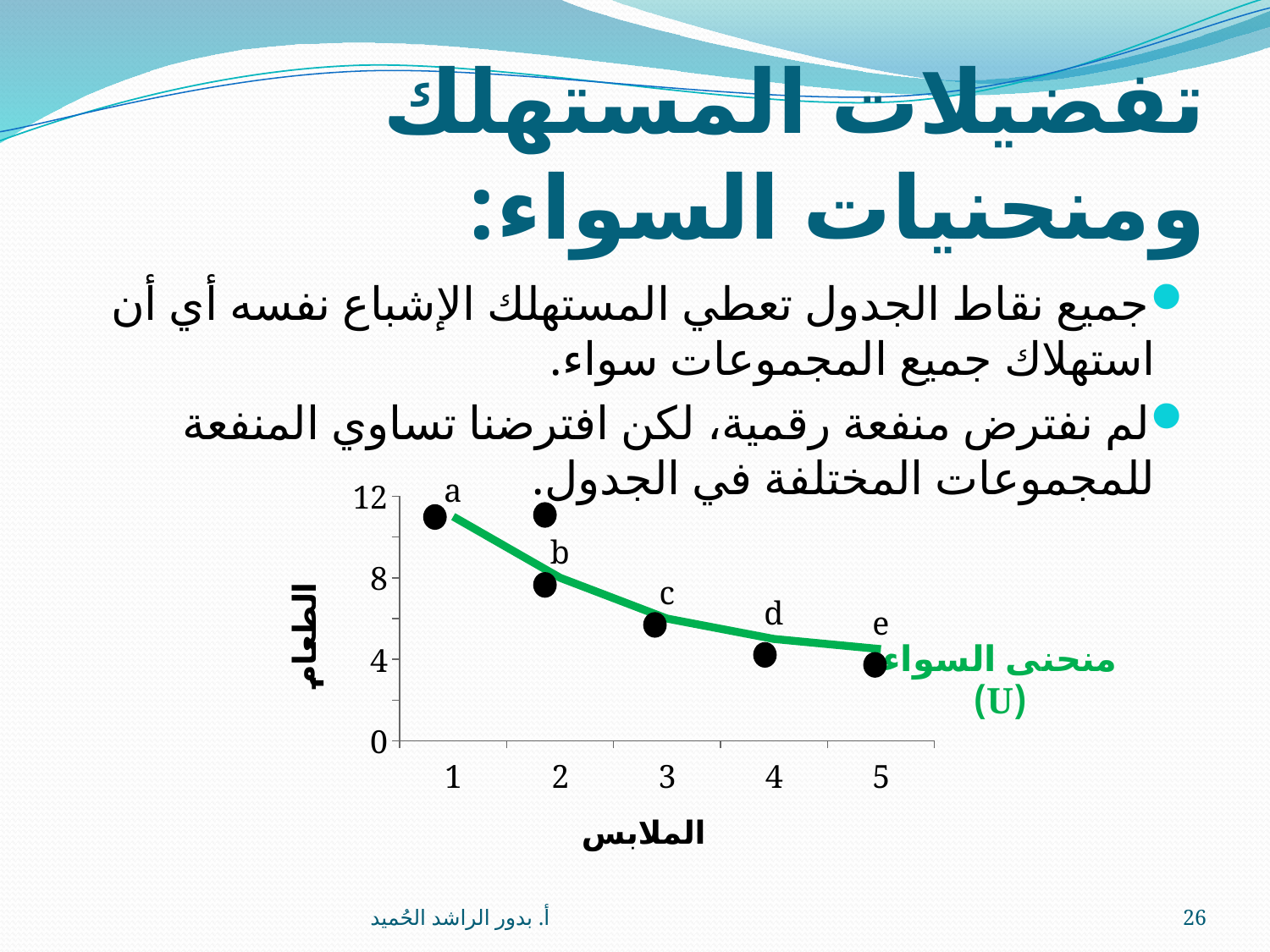
What label is given to the green curve on the chart? منحنى السواء (U) Is the value of الطعام at point c greater or less than 4? greater Is the value of الطعام at point e greater or less than 8? less As الملابس (clothing) increases from 1 to 5, does الطعام (food) rise or fall along the curve? fall What kind of chart is shown on the slide? line chart Which labeled point has the highest value of الطعام (food)? a What is the title of the x axis of the chart? الملابس Which point has a higher value of الطعام, a or c? a Is the value of الطعام at point a greater or less than 8? greater Which point has a higher value of الطعام, b or e? b How many labeled points (a to e) are plotted on the chart? 5